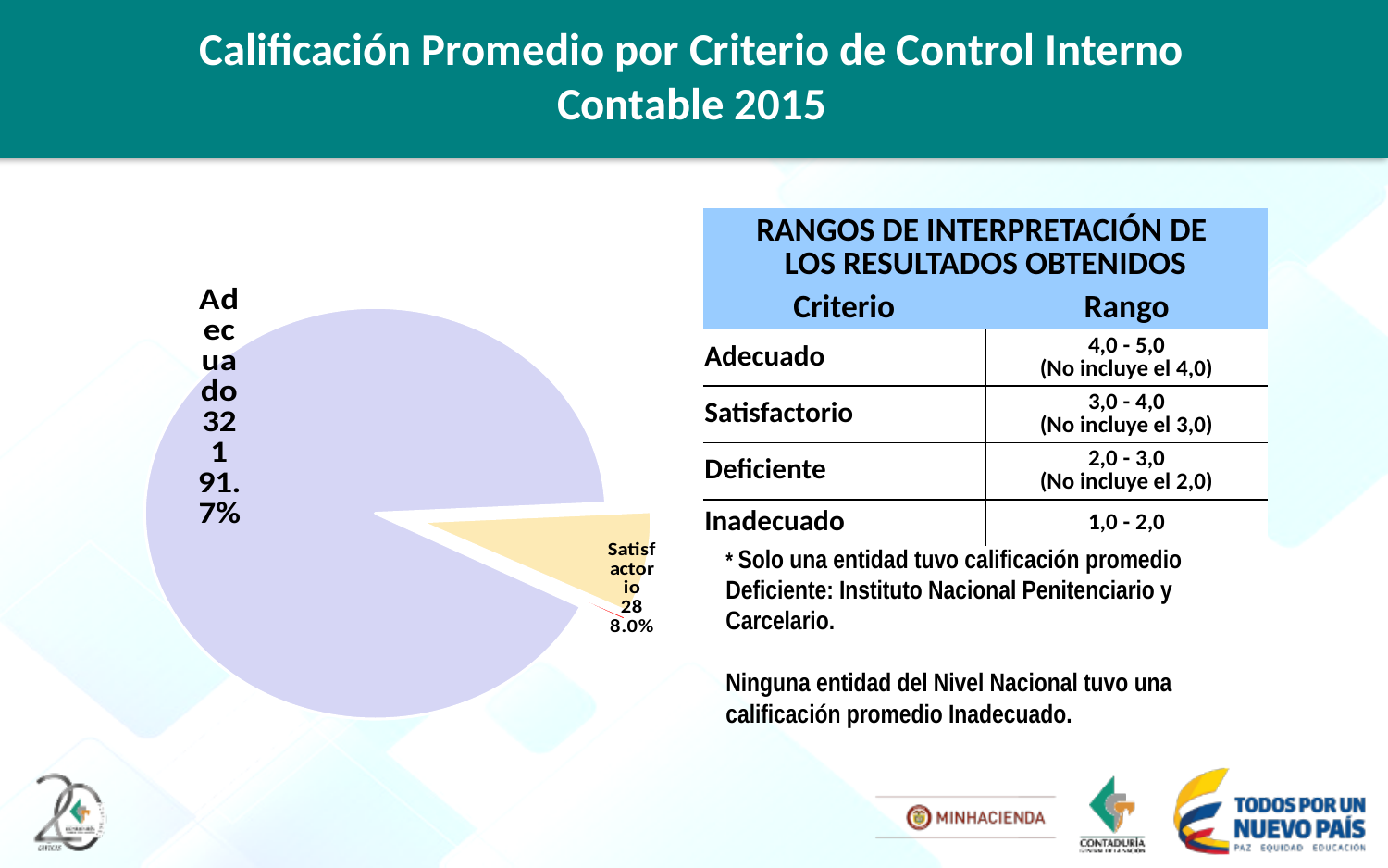
What type of chart is shown on the slide? pie chart What is the title of the slide containing the pie chart? Calificación Promedio por Criterio de Control Interno Contable 2015 What percentage of the pie does the Satisfactorio slice represent? 8.0% What is the count shown for the Satisfactorio slice? 28 What percentage of the pie does the Adecuado slice represent? 91.7% What is the count shown for the Adecuado slice? 321 Which has a larger count, Adecuado or Satisfactorio? Adecuado Which slice of the pie chart is the smallest? Deficiente What is the total of the two counts shown in the pie chart? 349 Which slice of the pie chart is the largest? Adecuado How many slices does the pie chart have? 3 What is the difference between the Adecuado count and the Satisfactorio count? 293